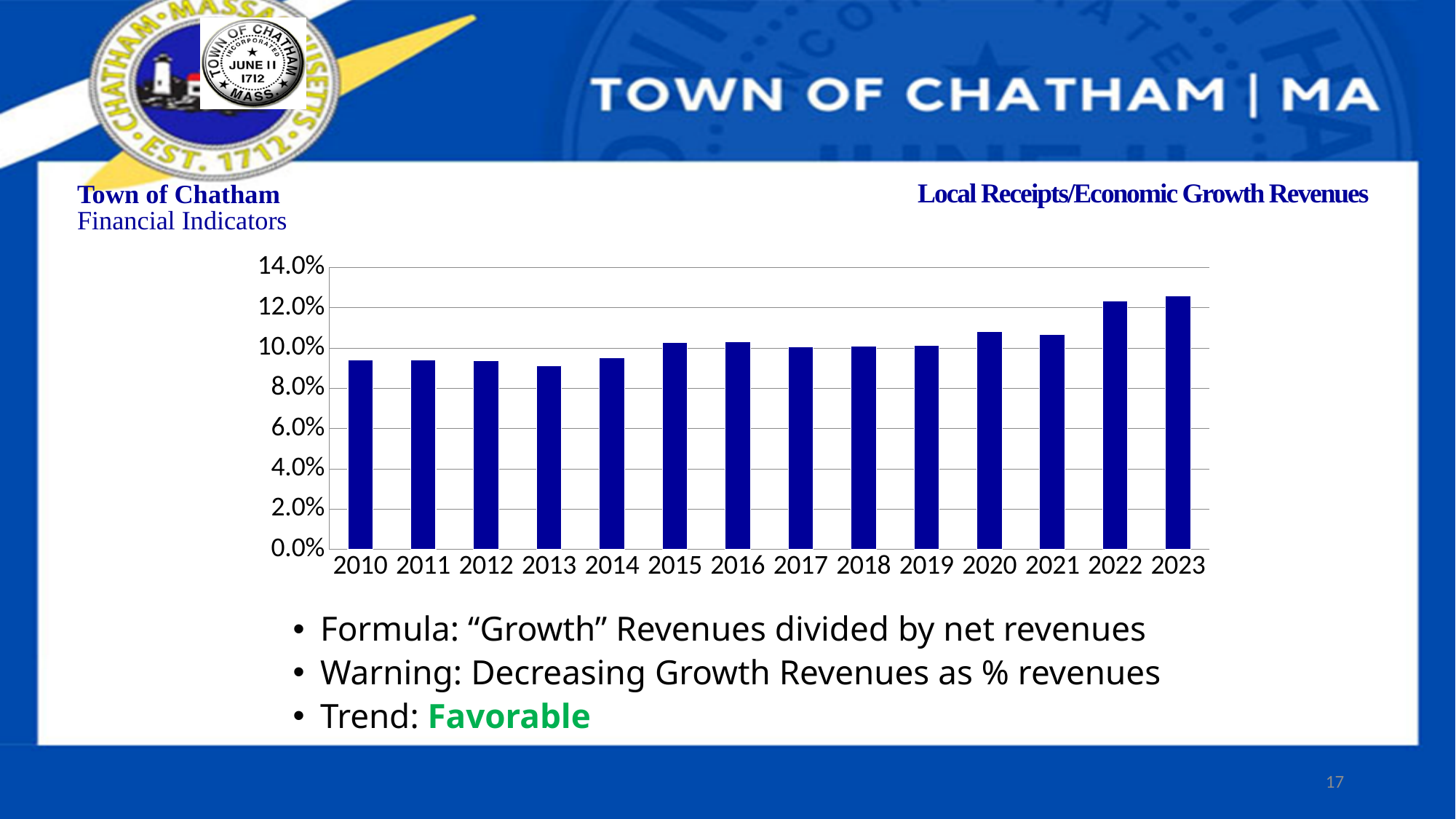
Is the value for 2020 greater or less than 10.0%? greater How many years are plotted on the x axis of the chart? 14 Is the value for 2022 greater or less than 12.0%? greater Which is larger, the value for 2022 or the value for 2010? 2022 Do the values generally rise or fall from 2010 to 2023? rise What is the title of the chart shown at the top right of the slide? Local Receipts/Economic Growth Revenues Is the value for 2013 greater or less than 10.0%? less What kind of chart is shown on the slide? bar chart Which is larger, the value for 2015 or the value for 2013? 2015 Which year has the lowest value in the chart? 2013 Which year has the highest value in the chart? 2023